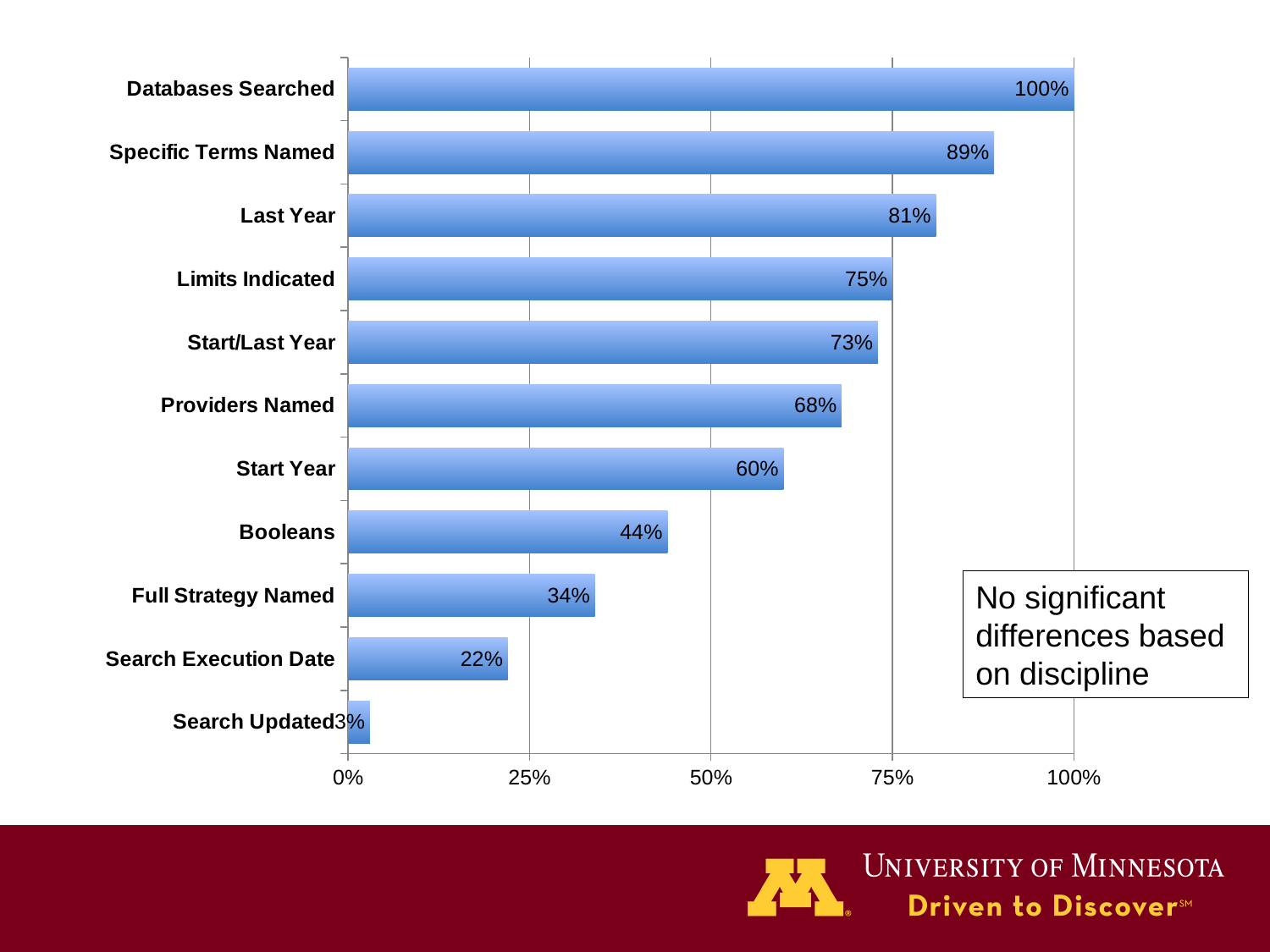
What is the value for Booleans? 44% Is the value for Full Strategy Named greater or less than 50%? less What does the text box on the chart say? No significant differences based on discipline What is the value for Specific Terms Named? 89% How many categories are shown in the chart? 11 What is the difference between the values for Last Year and Start Year? 21% What kind of chart is shown on the slide? bar chart What is the value for Databases Searched? 100% Which category has the highest value? Databases Searched What is the value for Search Execution Date? 22% Which is larger, the value for Limits Indicated or the value for Providers Named? Limits Indicated Which category has the lowest value? Search Updated